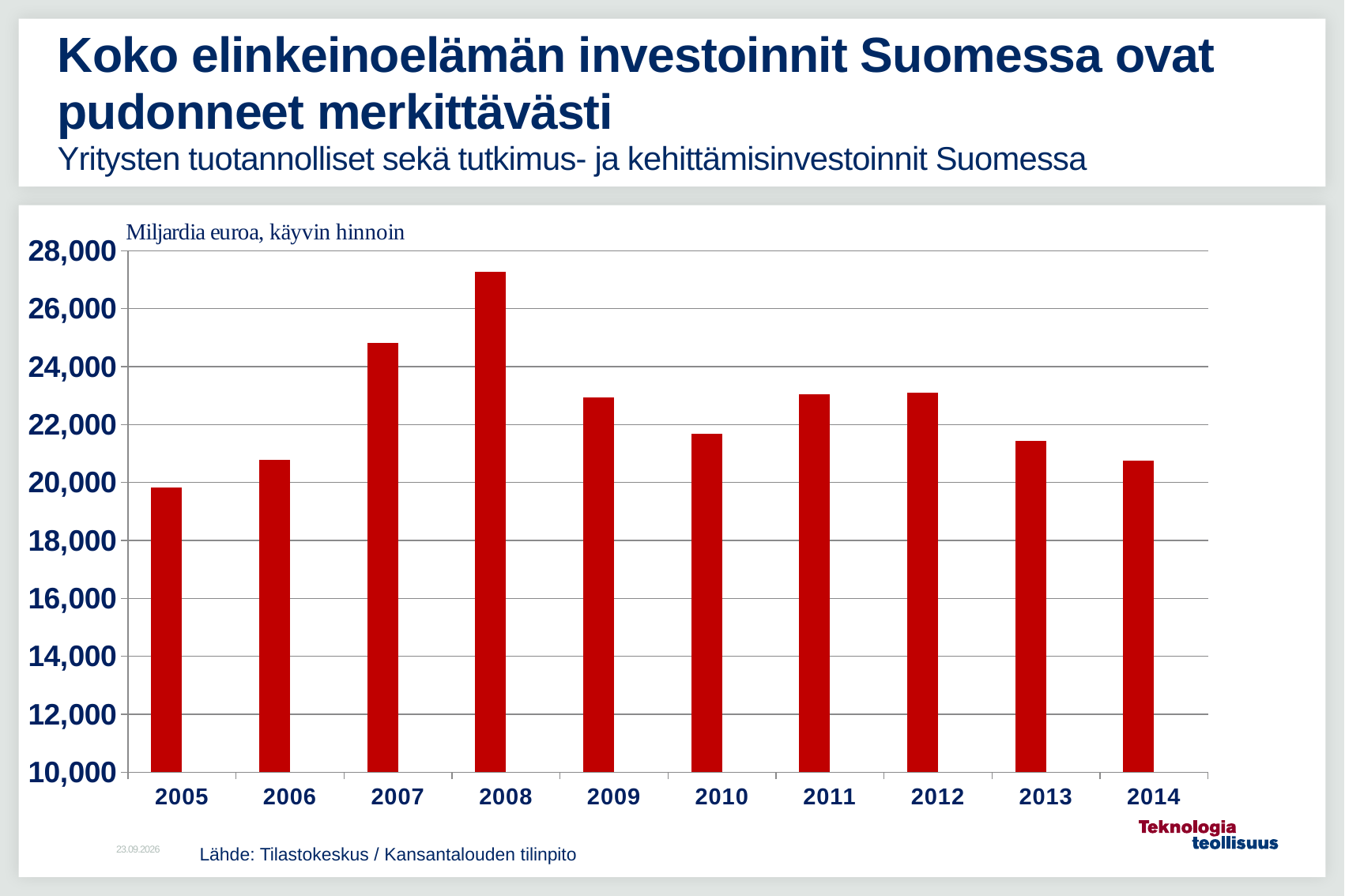
Is the value for 2010 greater or less than 22,000? less What kind of chart is shown on the slide? Bar chart Is the value for 2008 greater or less than 26,000? greater Which year has the highest value in the chart? 2008 Is the value for 2005 greater or less than 20,000? less Do the values rise or fall from 2005 to 2008? rise How many years are shown on the x axis of the chart? 10 Which year has the lowest value in the chart? 2005 Which is larger, the value for 2007 or the value for 2009? 2007 What unit label is shown above the chart's y axis? Miljardia euroa, käyvin hinnoin